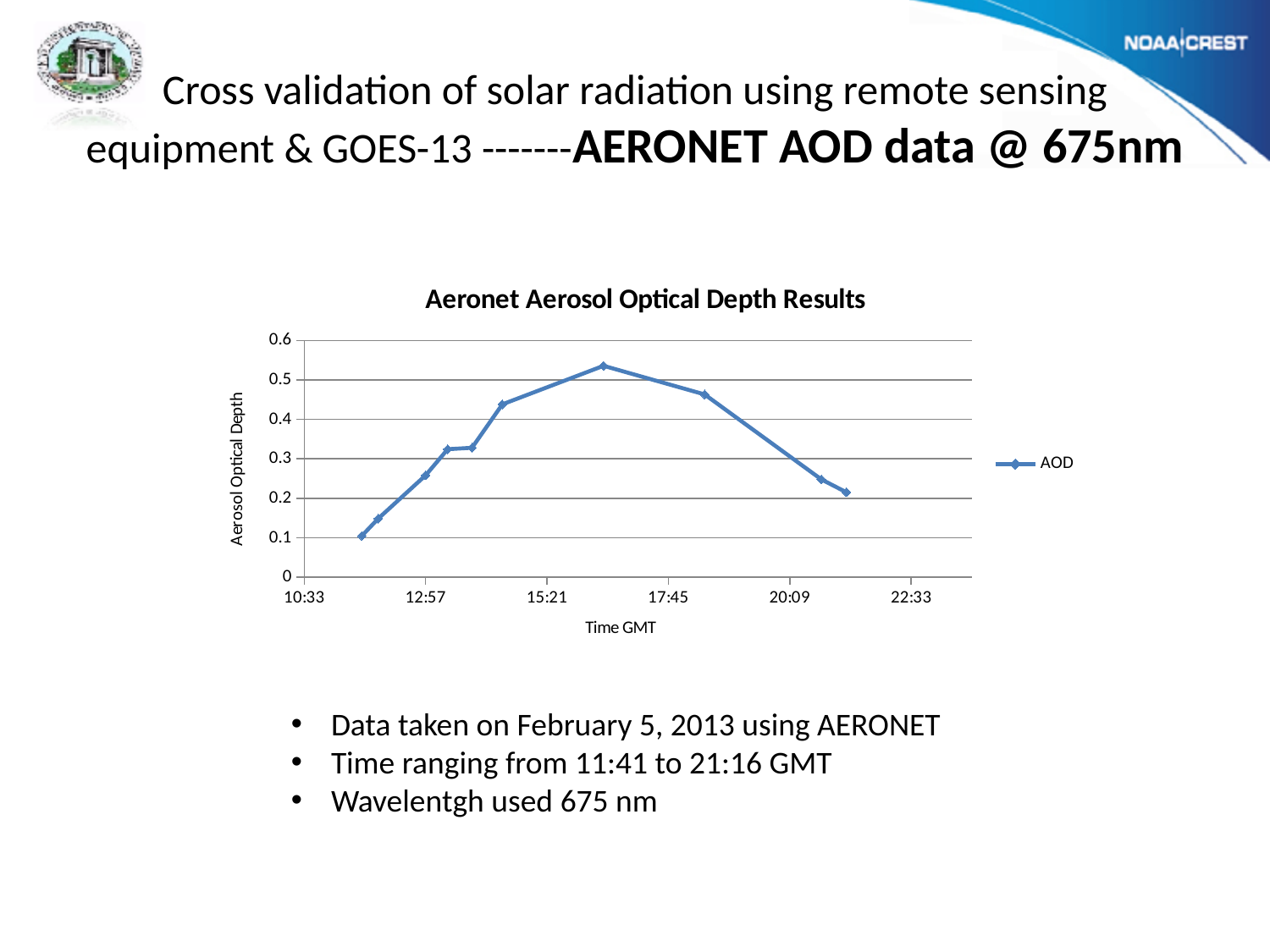
What is the title of the chart? Aeronet Aerosol Optical Depth Results How does the AOD value change along the x axis over the day? rises to a peak then falls Is the highest AOD value on the chart greater or less than 0.5? greater What kind of chart is shown on the slide? line chart Is the first (leftmost) AOD value on the chart greater or less than 0.2? less What is the name of the series shown in the legend? AOD Between which two x-axis tick labels does the peak AOD value occur? 15:21 and 17:45 Is the AOD value at about 12:57 GMT greater or less than 0.3? less Does the lowest AOD value occur at the start or the end of the time series? start How many series does the chart legend list? 1